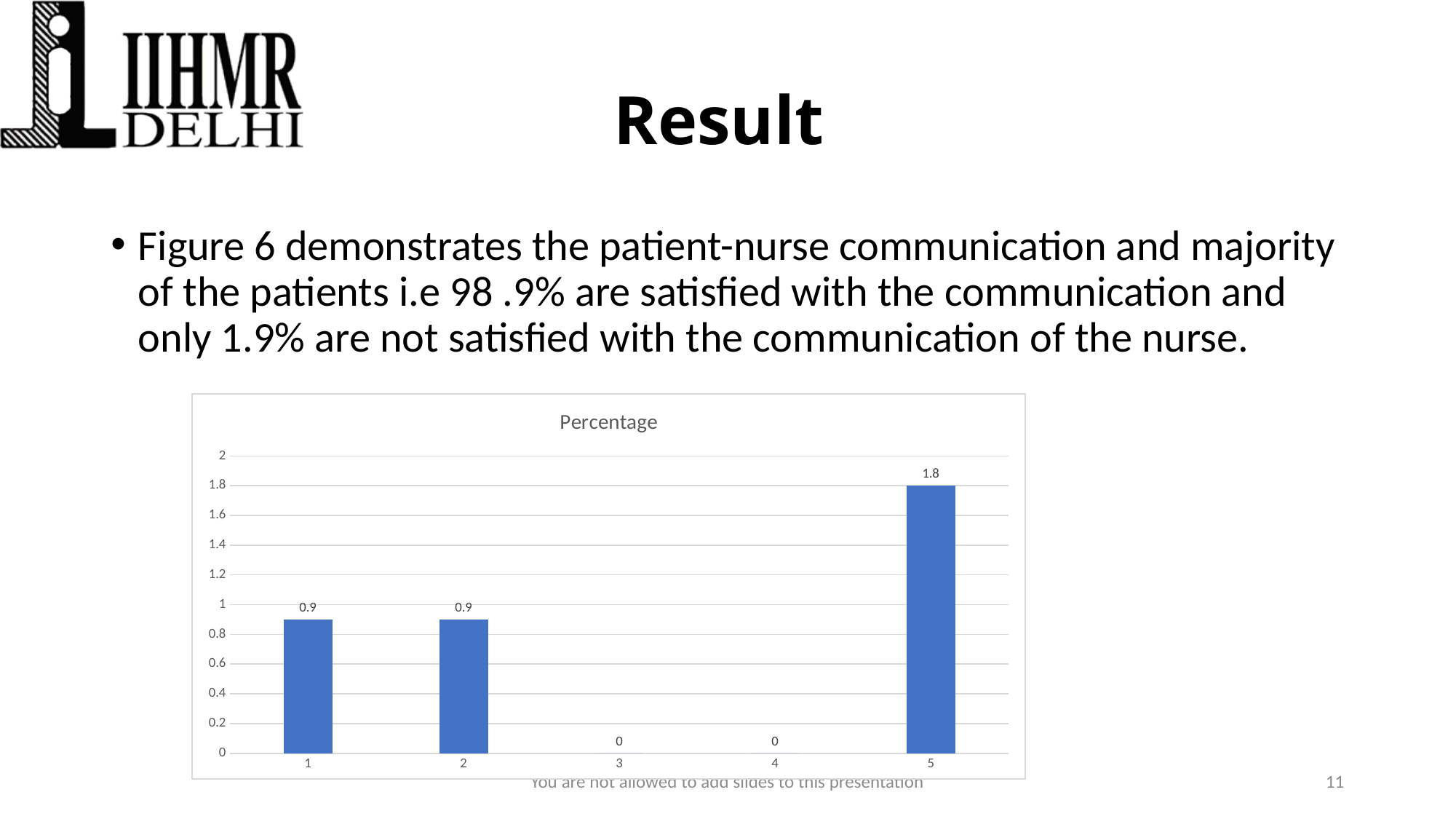
What is the value for category 3? 0 What is the total of the values for categories 1 and 2? 1.8 How many categories have a value of 0? 2 What is the title of the chart? Percentage What is the difference between the values for category 5 and category 2? 0.9 What is the value for category 5? 1.8 Which is larger, the value for category 1 or the value for category 5? category 5 Which category has the highest value? 5 What kind of chart is shown on the slide? bar chart Is the value for category 5 greater or less than 1? greater What is the value for category 1? 0.9 How many categories are shown on the x axis? 5